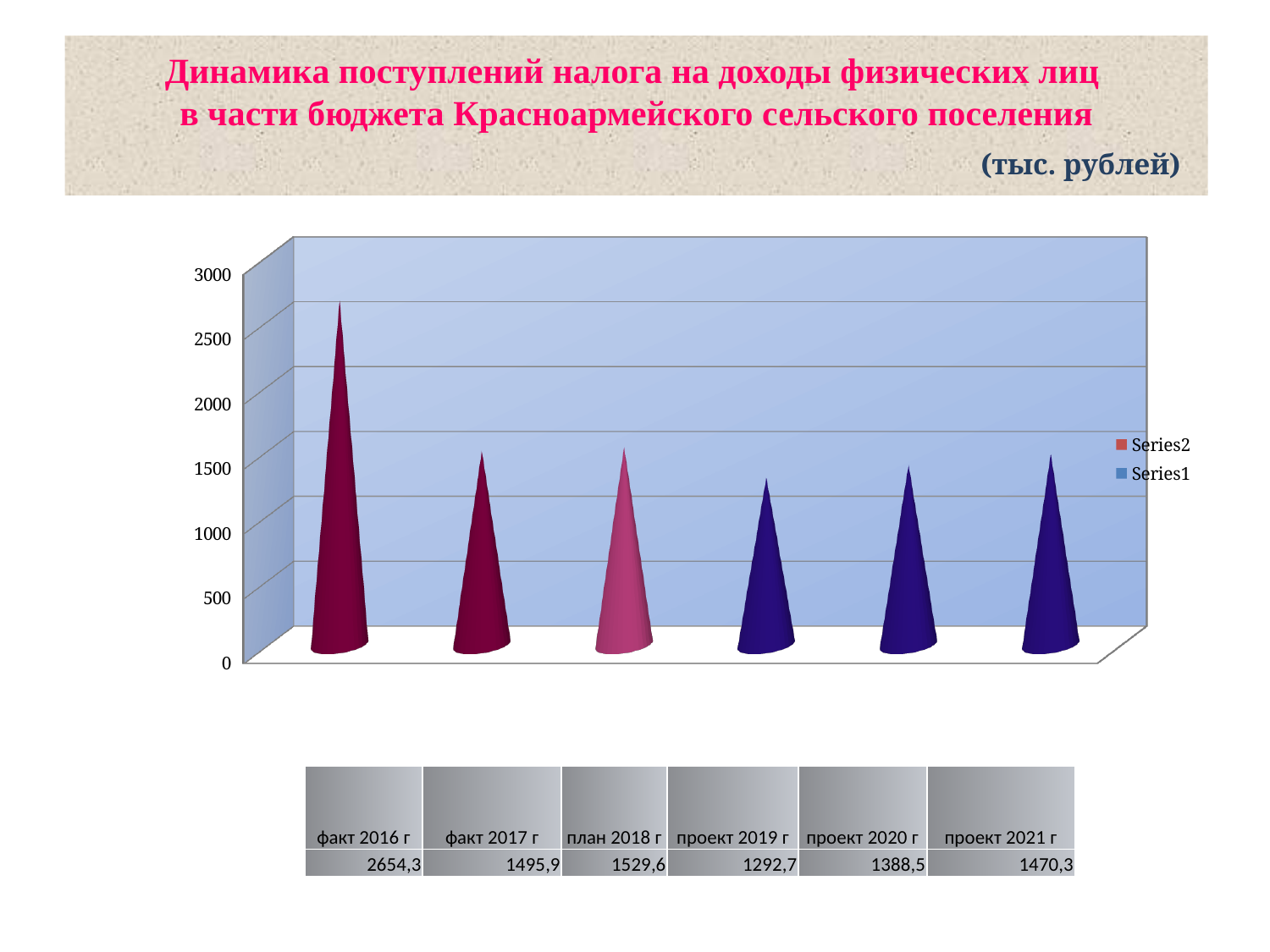
What is the value for факт 2016 г? 2654,3 What is the value for проект 2020 г? 1388,5 What kind of chart is shown on the slide? bar chart What is the difference between the values for проект 2021 г and проект 2020 г? 81,8 What is the value for план 2018 г? 1529,6 Is the value for факт 2016 г greater or less than 2500? greater What is the difference between the values for факт 2016 г and факт 2017 г? 1158,4 How many series does the legend list? 2 Which category has the lowest value? проект 2019 г How many categories are shown on the x axis? 6 Which category has the highest value? факт 2016 г Which is larger, the value for план 2018 г or the value for факт 2017 г? план 2018 г